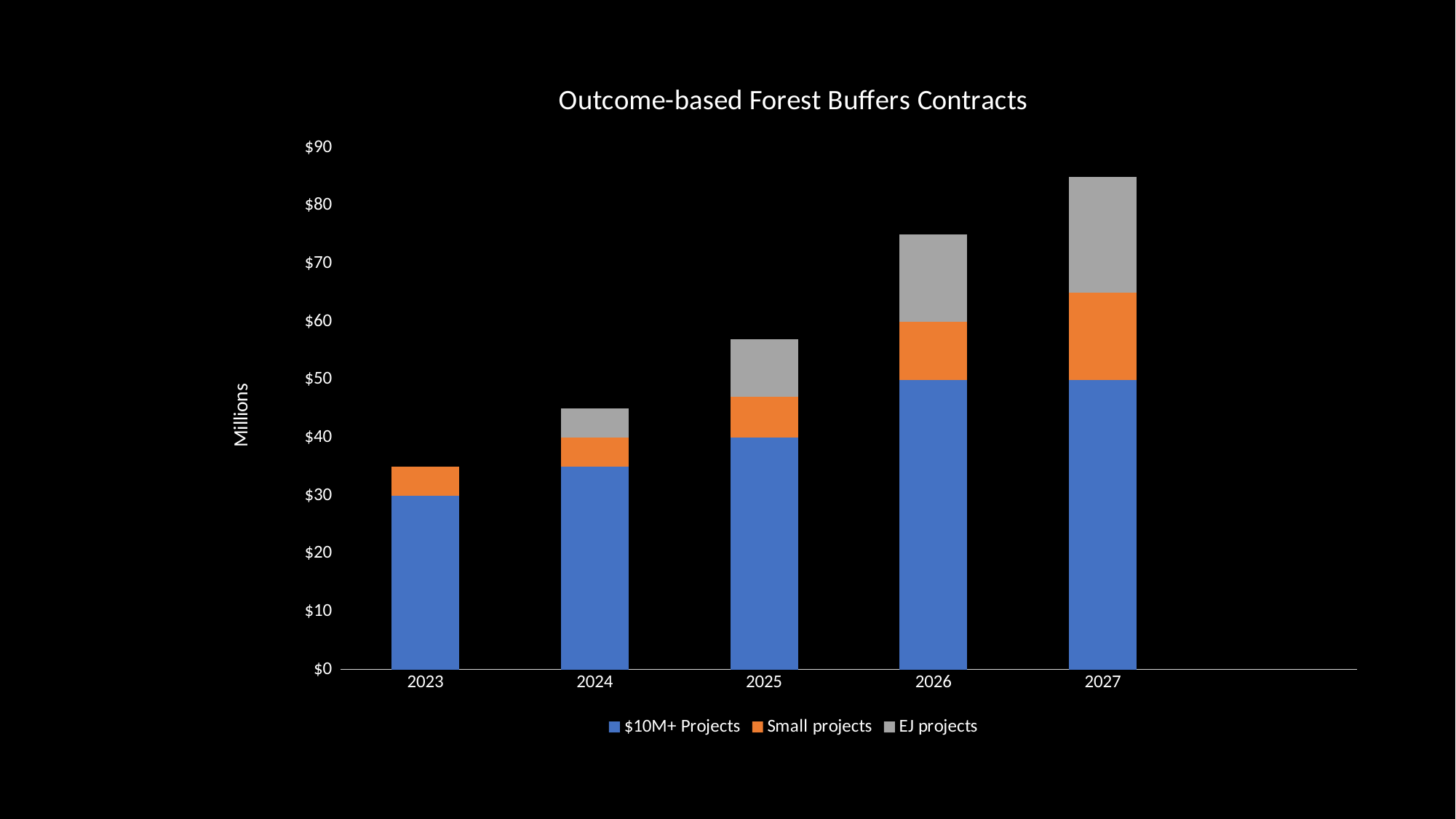
How many years are shown on the x axis? 5 What is the value for $10M+ Projects in 2026? $50 Is the total bar for 2023 greater or less than $40? less What kind of chart is shown on the slide? Stacked bar chart What is the value for $10M+ Projects in 2023? $30 Which year has the tallest total bar? 2027 What is the title of the chart? Outcome-based Forest Buffers Contracts Do the total bar heights rise or fall from 2023 to 2027? Rise Which colour represents EJ projects in the legend? Grey How many series does the legend list? 3 Is the total bar for 2027 greater or less than $80? greater Which year has the shortest total bar? 2023